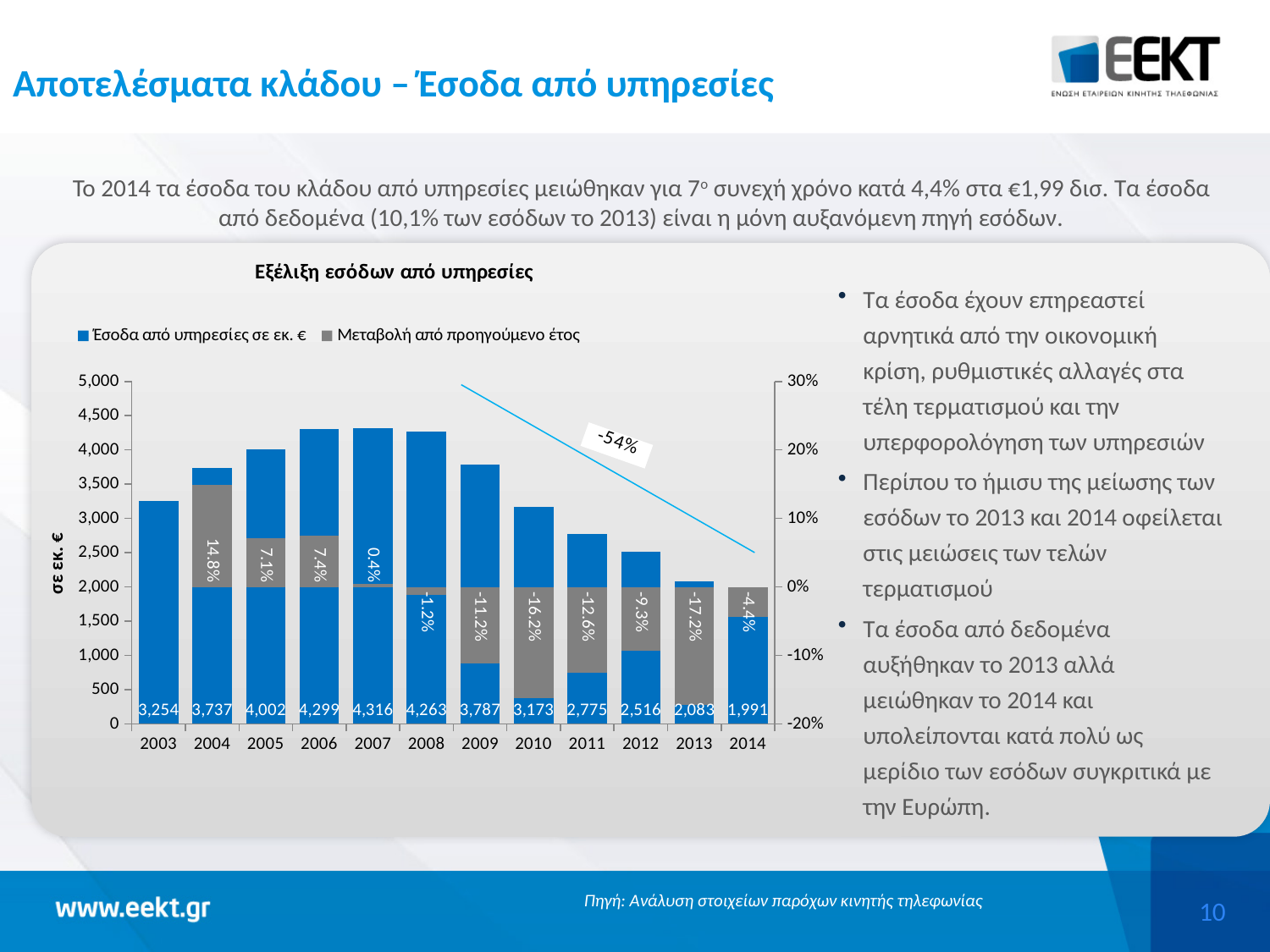
Which year has the highest revenue from services? 2007 What is the revenue from services (in million €) for 2007? 4,316 Which year has the larger revenue from services, 2009 or 2011? 2009 What is the change from the previous year shown for 2004? 14.8% Do the revenues from services rise or fall from 2007 to 2014? fall What kind of chart is used to show the revenue from services? bar chart How many series does the chart legend list? 2 What is the change from the previous year shown for 2013? -17.2% What is the difference in revenue from services between 2003 and 2014 (in million €)? 1,263 Which year has the lowest revenue from services? 2014 What is the revenue from services (in million €) for 2014? 1,991 How many years are shown on the x axis of the chart? 12